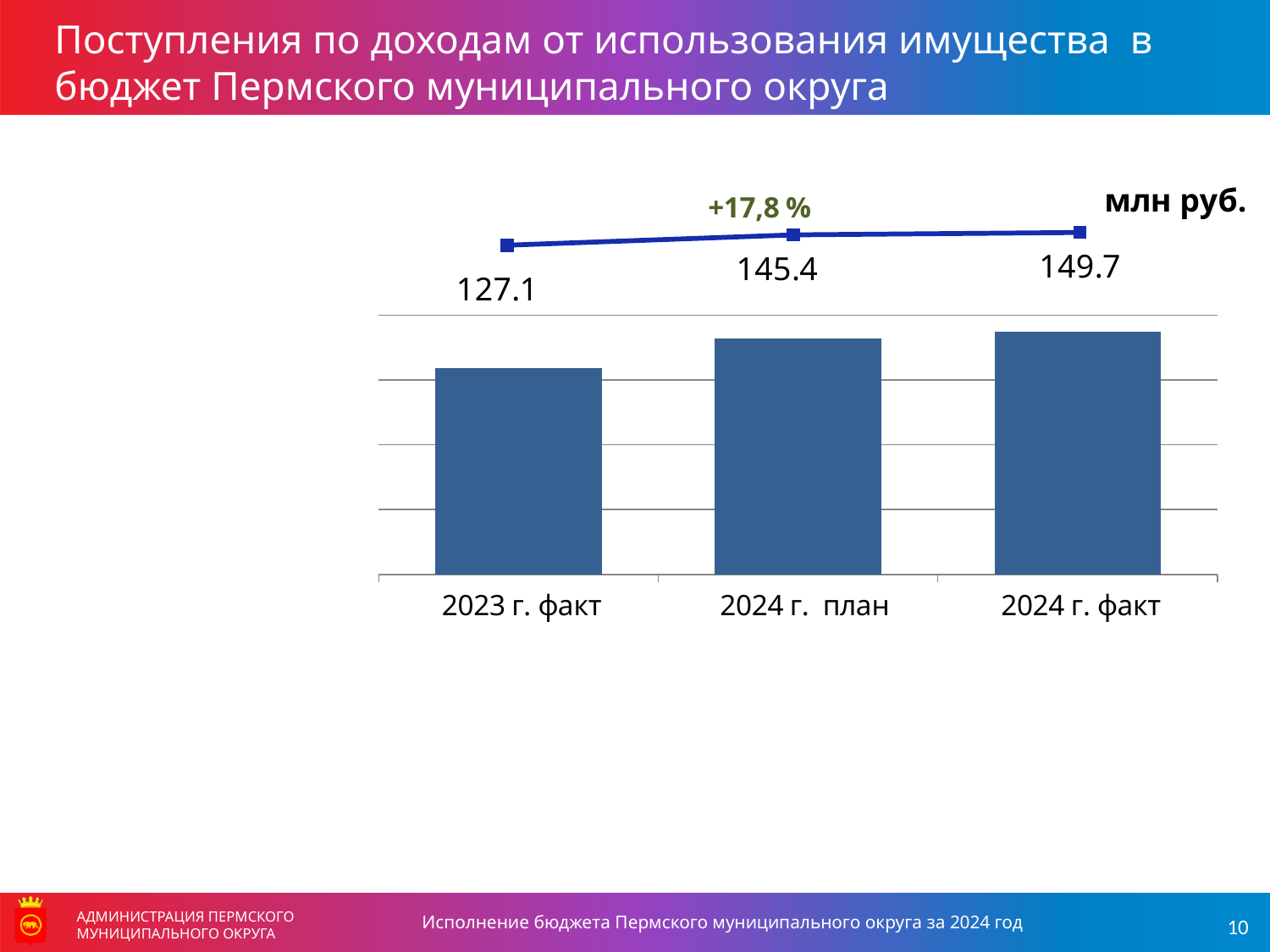
What is the difference between the values for 2024 г. факт and 2024 г. план? 4.3 What percentage change is annotated above the line on the chart? +17,8 % How many categories are shown on the x axis? 3 Which is larger, the value for 2024 г. план or the value for 2023 г. факт? 2024 г. план Which category has the highest value? 2024 г. факт Do the values rise or fall from left to right along the x axis? rise What is the value for 2024 г. план? 145.4 What is the value for 2024 г. факт? 149.7 What is the value for 2023 г. факт? 127.1 What kind of chart is this? bar chart What is the difference between the values for 2024 г. факт and 2023 г. факт? 22.6 Which category has the lowest value? 2023 г. факт